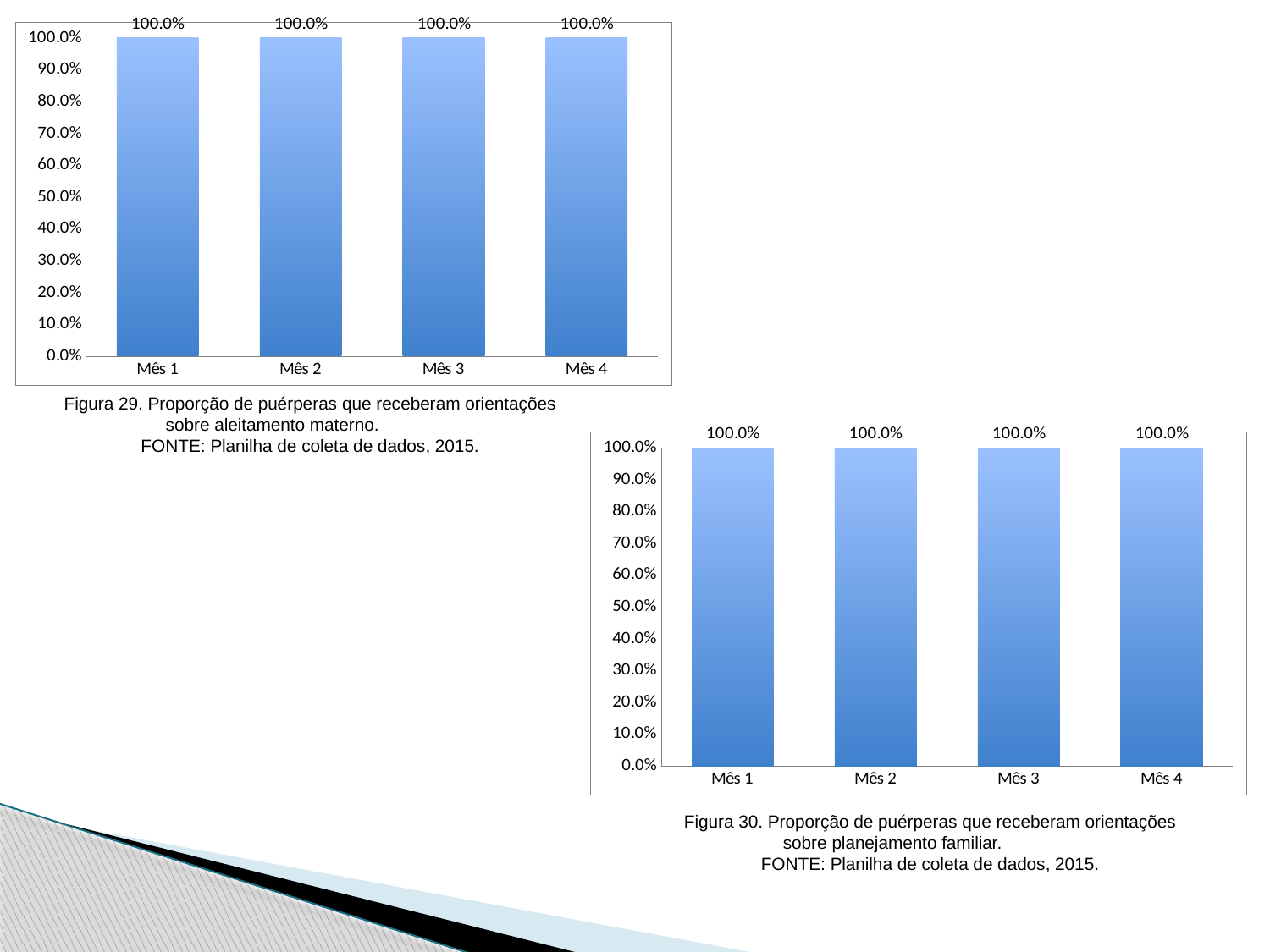
How many bars are plotted in the Figura 30 chart (bottom right)? 4 What kind of chart is the Figura 29 chart (top left)? Bar chart In the Figura 30 chart (bottom right), what is the value for Mês 3? 100.0% In the Figura 29 chart (top left), do the values rise, fall or stay the same from Mês 1 to Mês 4? Stay the same How many categories are shown on the x axis of the Figura 29 chart (top left)? 4 What is the caption title of the chart at the bottom right of the slide? Figura 30. Proporção de puérperas que receberam orientações sobre planejamento familiar. In the Figura 30 chart (bottom right), is the value for Mês 1 greater or less than 50.0%? greater What is the difference between the values for Mês 1 and Mês 4 in the Figura 30 chart (bottom right)? 0.0% In the Figura 30 chart (bottom right), what is the value for Mês 2? 100.0% What source is cited below the Figura 29 chart (top left)? Planilha de coleta de dados, 2015 In the Figura 29 chart (top left), what is the value for Mês 4? 100.0% In the Figura 29 chart (top left), what is the value for Mês 1? 100.0%